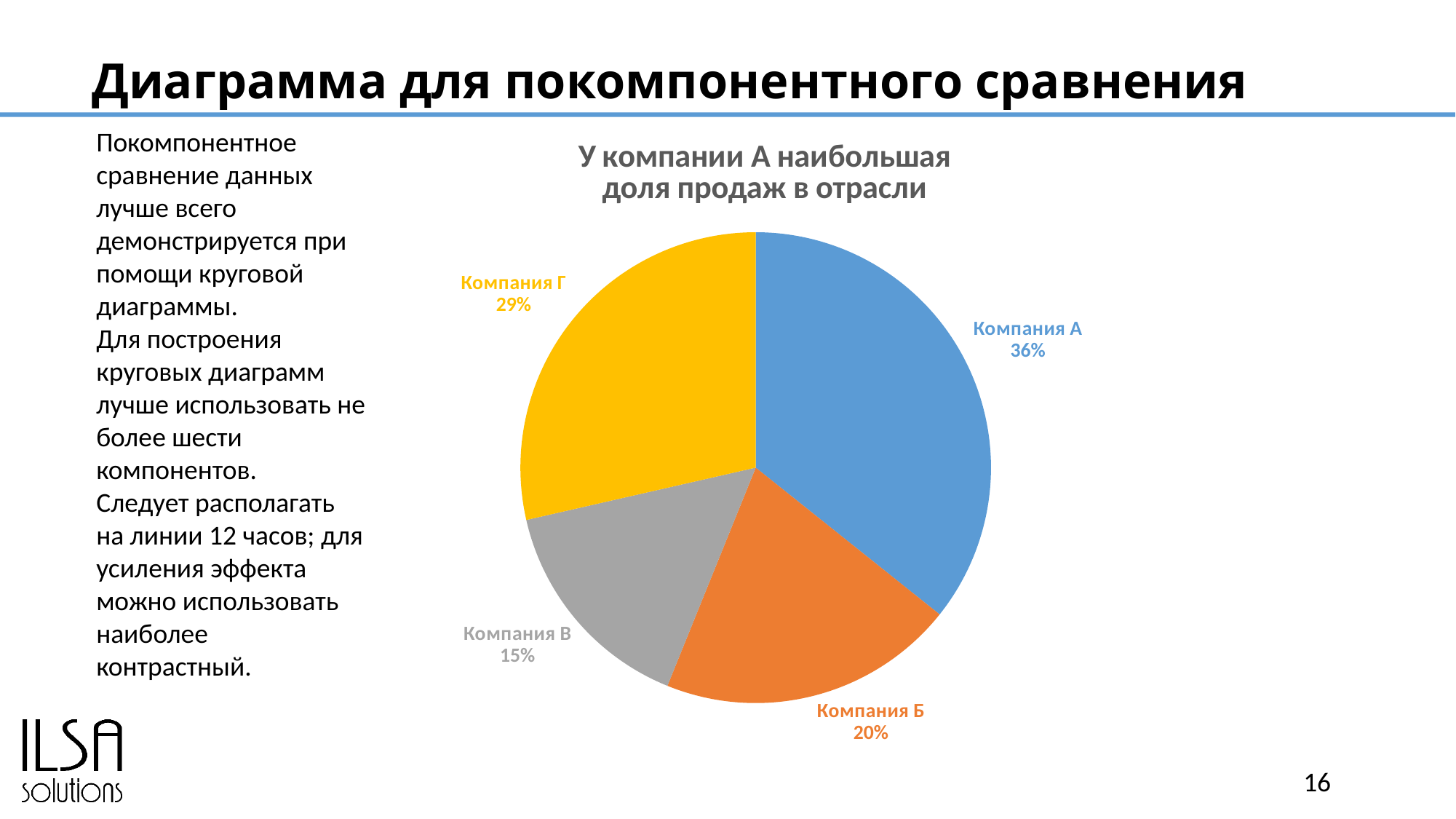
What is the share for Компания А? 36% What is the difference in percentage points between Компания А and Компания Г? 7 What is the share for Компания В? 15% Which company has the largest slice of the pie? Компания А What is the share for Компания Б? 20% Which company has the smallest slice of the pie? Компания В How many companies are shown in the pie chart? 4 What is the share for Компания Г? 29% Which is larger, the share of Компания Б or the share of Компания В? Компания Б What colour is the slice for Компания Г? Yellow What type of chart is shown on the slide? Pie chart What is the title of the chart? У компании А наибольшая доля продаж в отрасли